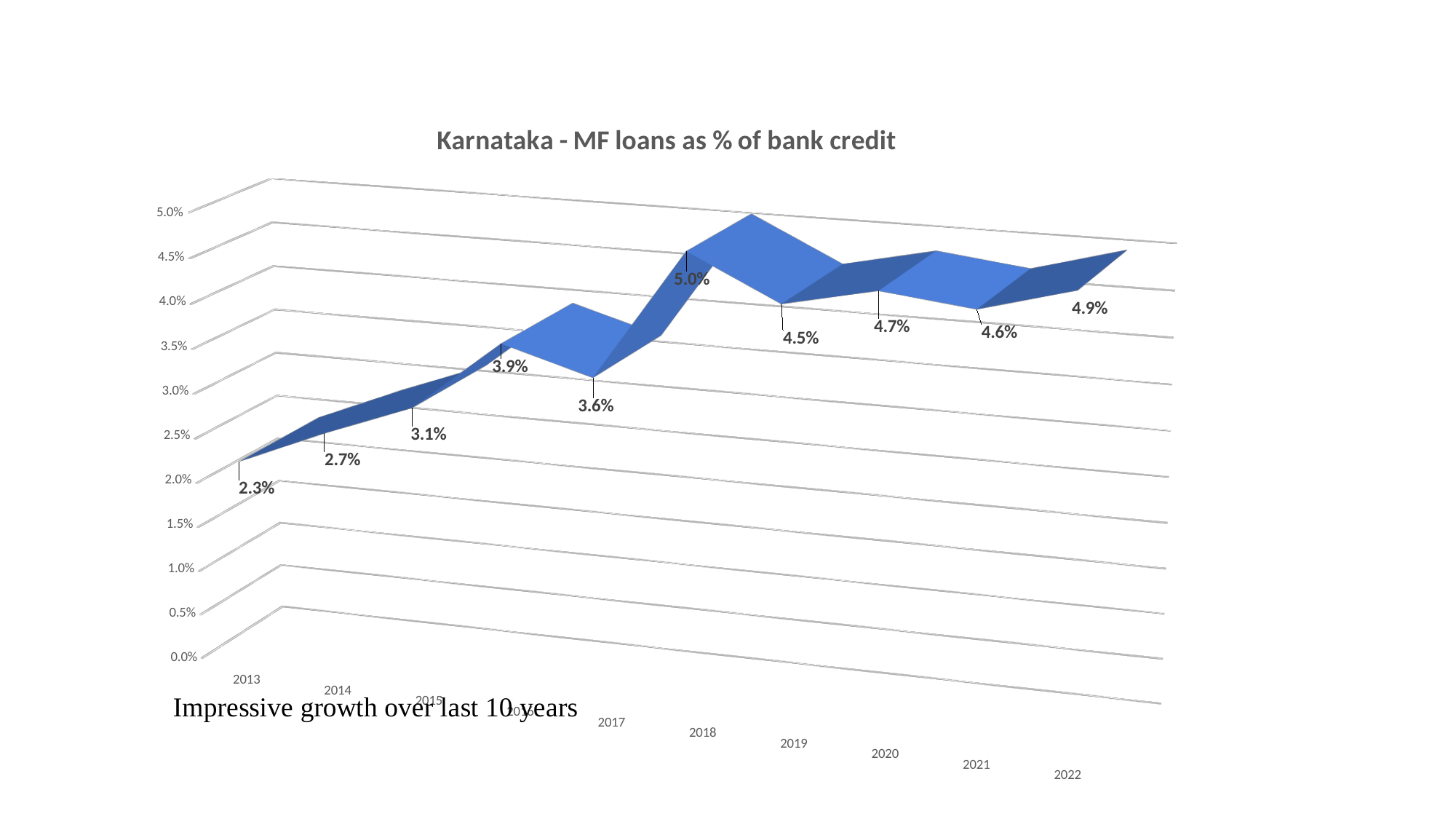
What kind of chart is shown on the slide? Line chart What is the value for 2013? 2.3% How many years are plotted on the chart? 10 What is the value for 2018? 5.0% What is the value for 2020? 4.7% Which is larger, the value for 2017 or the value for 2019? 2019 What is the difference between the values for 2022 and 2013? 2.6 percentage points Which year has the highest value? 2018 What is the value for 2022? 4.9% Which year has the lowest value? 2013 What is the title of the chart? Karnataka - MF loans as % of bank credit Do the values generally rise or fall from 2013 to 2022? Rise